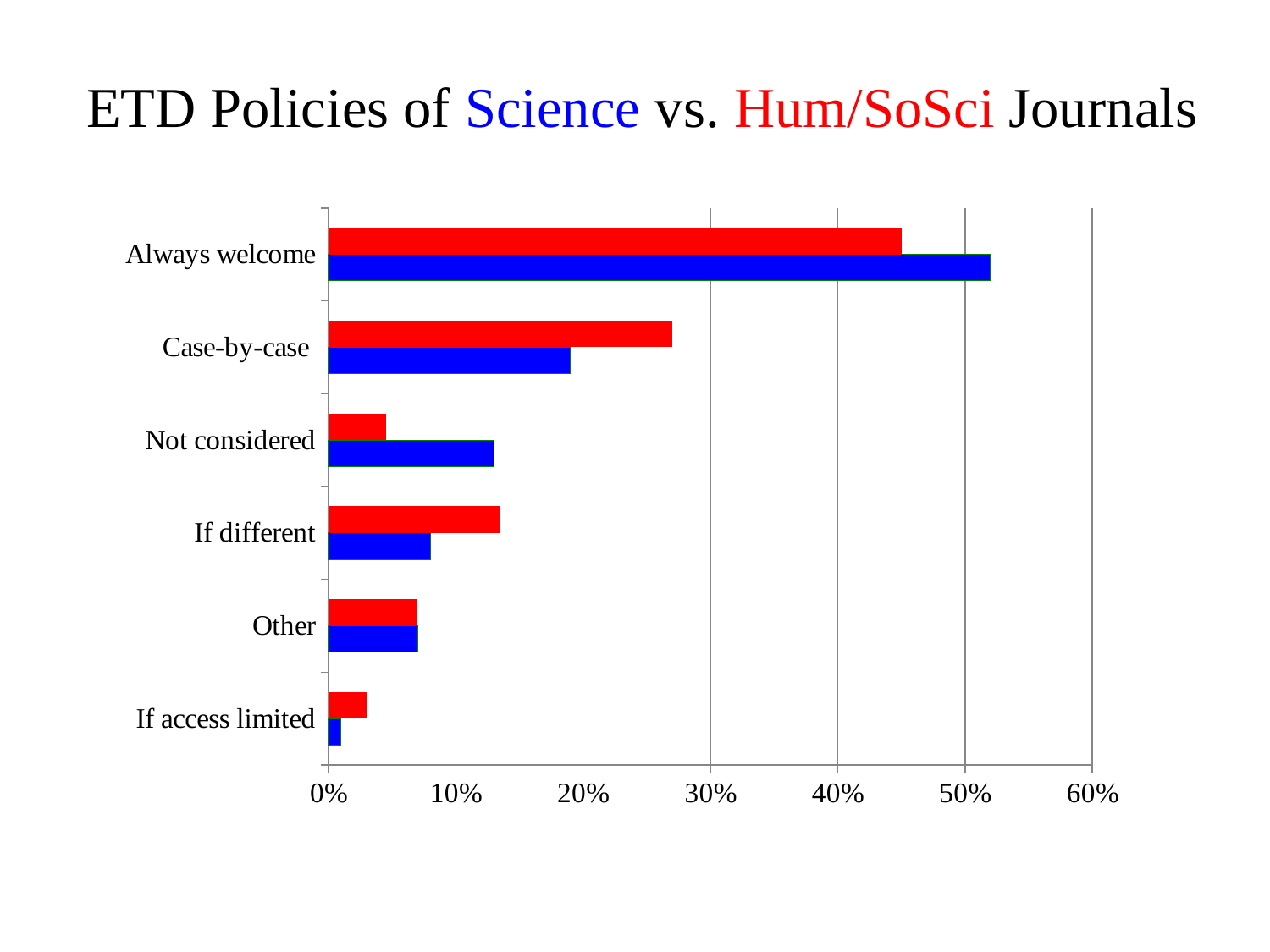
For Always welcome, which is larger: the Science bar or the Hum/SoSci bar? Science How many policy categories are shown on the y axis of the chart? 6 Which category has the longest blue (Science) bar? Always welcome Which category has the shortest red (Hum/SoSci) bar? If access limited Which colour represents Science journals in the chart? blue For Case-by-case, which is larger: the Science bar or the Hum/SoSci bar? Hum/SoSci Is the Science value for Not considered greater or less than 10%? greater Is the Hum/SoSci value for Case-by-case greater or less than 20%? greater What kind of chart is shown on the slide? bar chart Is the Hum/SoSci value for Always welcome greater or less than 40%? greater